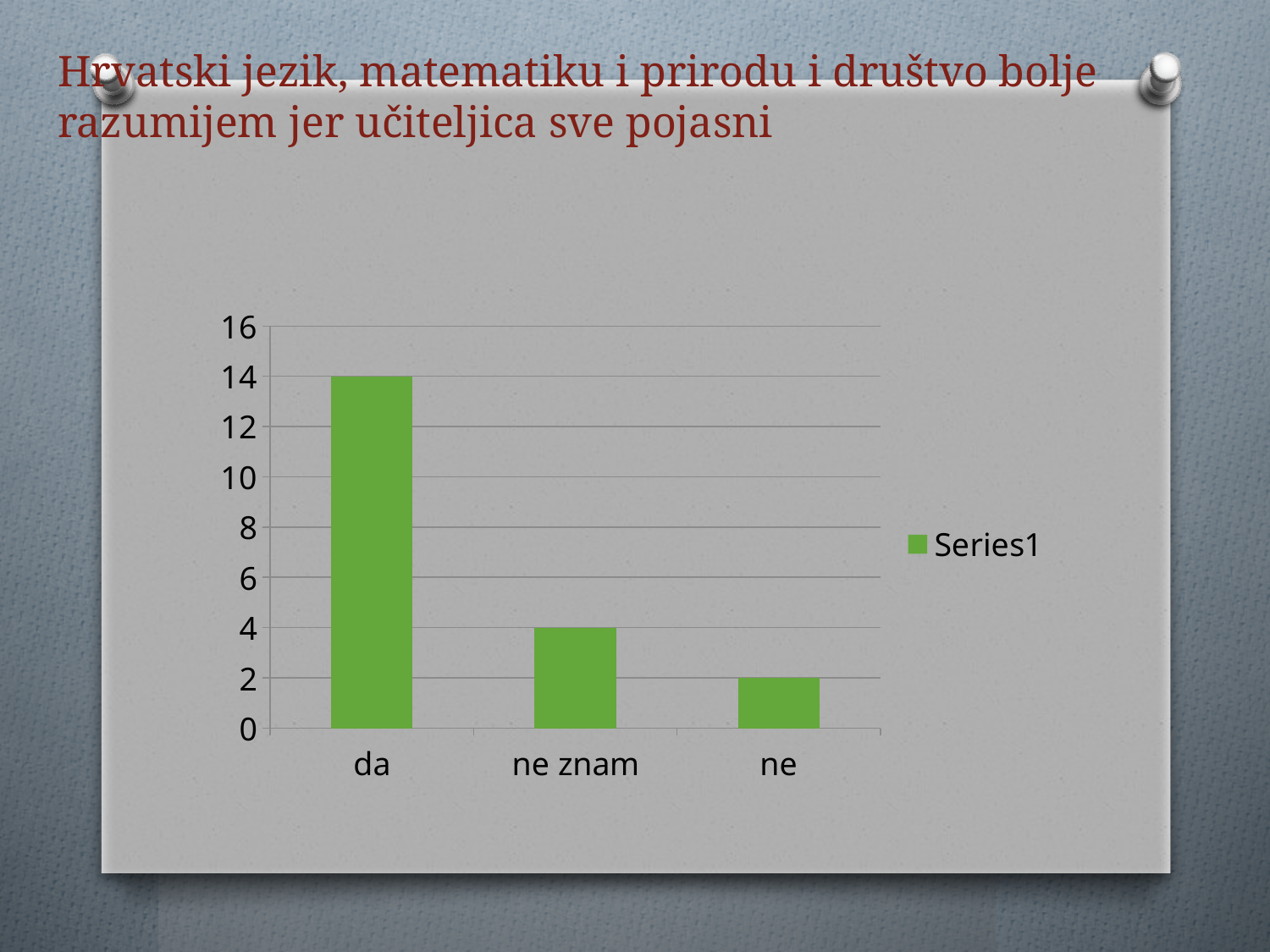
How many categories are shown on the x axis? 3 Which category has the highest value? da What is the value for "da"? 14 What is the value for "ne"? 2 Is the value for "da" greater or less than 10? greater What is the difference between the values for "ne znam" and "ne"? 2 How many series does the legend list? 1 What is the difference between the values for "da" and "ne znam"? 10 Which is larger, the value for "ne znam" or the value for "ne"? ne znam What kind of chart is shown on the slide? bar chart What is the value for "ne znam"? 4 Which category has the lowest value? ne